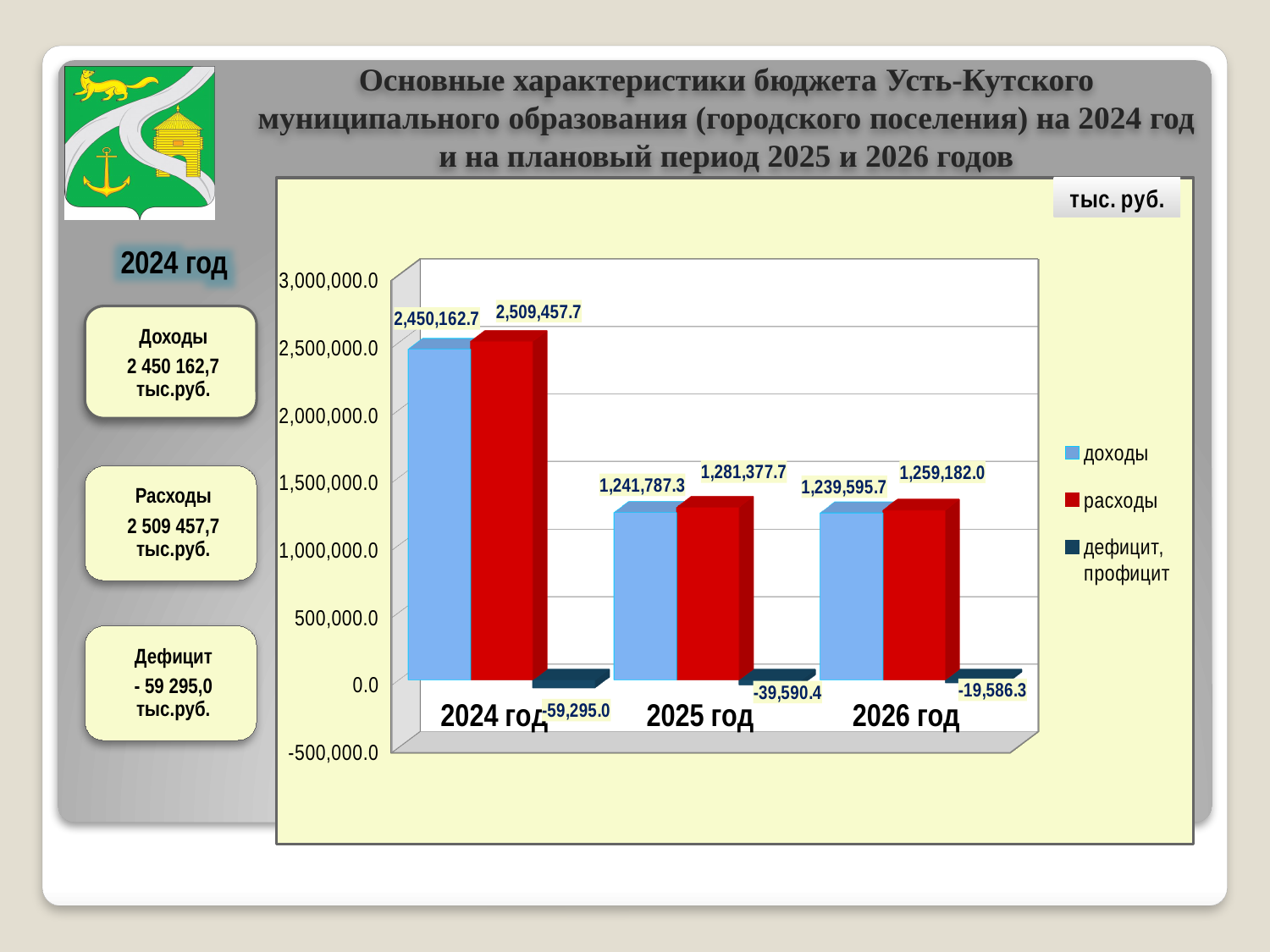
What is the difference between расходы and доходы for 2024 год? 59,295.0 What is the difference between доходы for 2024 год and доходы for 2025 год? 1,208,375.4 How many series does the legend list? 3 Which is larger for 2026 год: доходы or расходы? расходы In which year is the value of дефицит, профицит the lowest (most negative)? 2024 год Do the values of доходы rise or fall from 2024 год to 2026 год? fall What is the value of доходы for 2024 год? 2,450,162.7 What kind of chart is shown on the slide? bar chart In which year are расходы the highest? 2024 год How many years (categories) are shown on the x axis? 3 What is the value of дефицит, профицит for 2026 год? -19,586.3 What is the value of расходы for 2025 год? 1,281,377.7